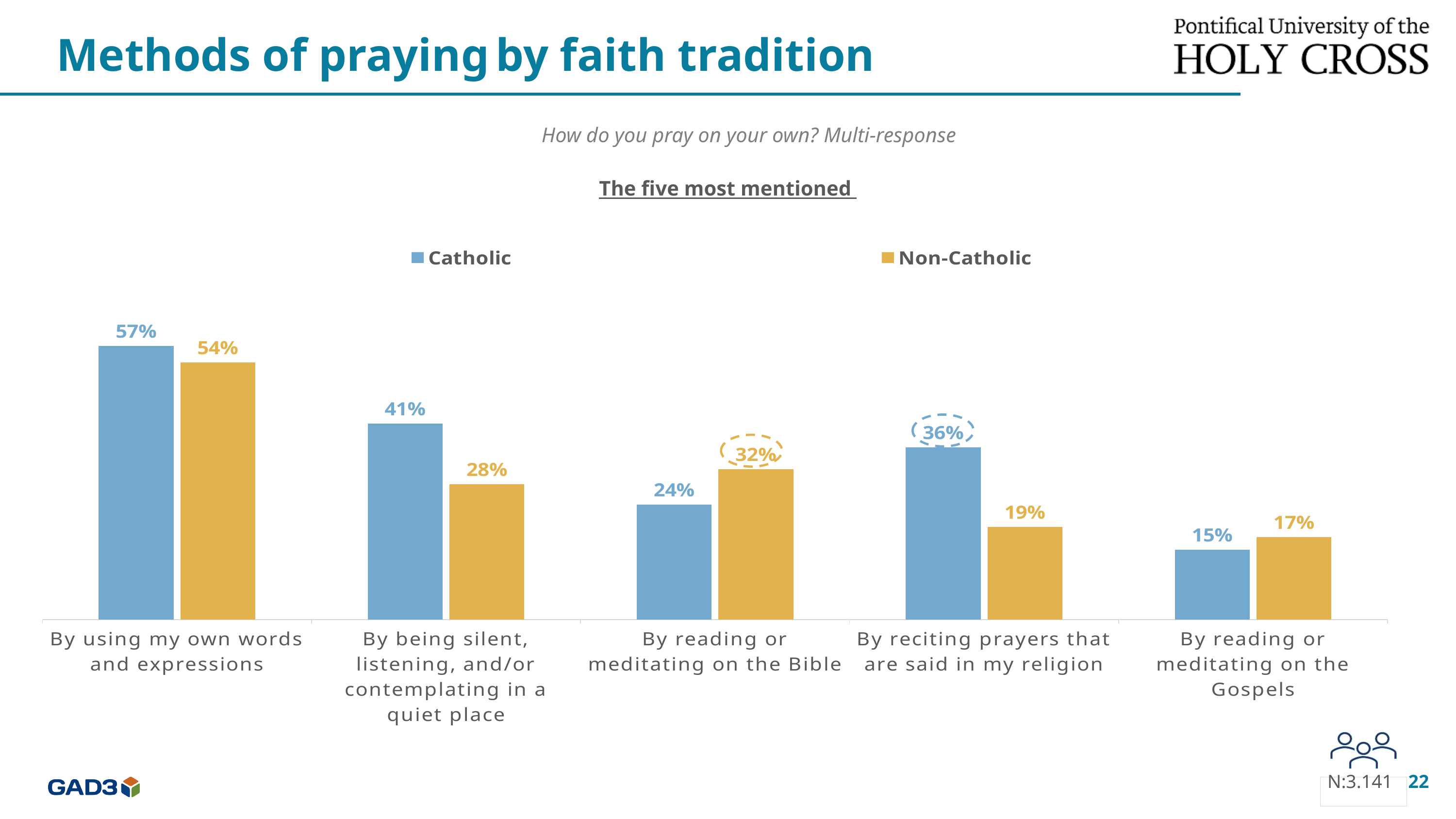
What is the difference between the Catholic and Non-Catholic values for 'By reciting prayers that are said in my religion'? 17% What kind of chart is shown on the slide? Bar chart How many methods of praying are shown on the chart? 5 For 'By reading or meditating on the Bible', which group has the larger value, Catholic or Non-Catholic? Non-Catholic What is the Non-Catholic value for 'By reading or meditating on the Gospels'? 17% What is the Catholic value for 'By reciting prayers that are said in my religion'? 36% Which method has the lowest Non-Catholic value? By reading or meditating on the Gospels Which method has the highest Catholic value? By using my own words and expressions What is the difference between the Catholic and Non-Catholic values for 'By being silent, listening, and/or contemplating in a quiet place'? 13% How many series does the legend list? 2 What is the Non-Catholic value for 'By reading or meditating on the Bible'? 32% What percentage of Catholics pray by using their own words and expressions? 57%